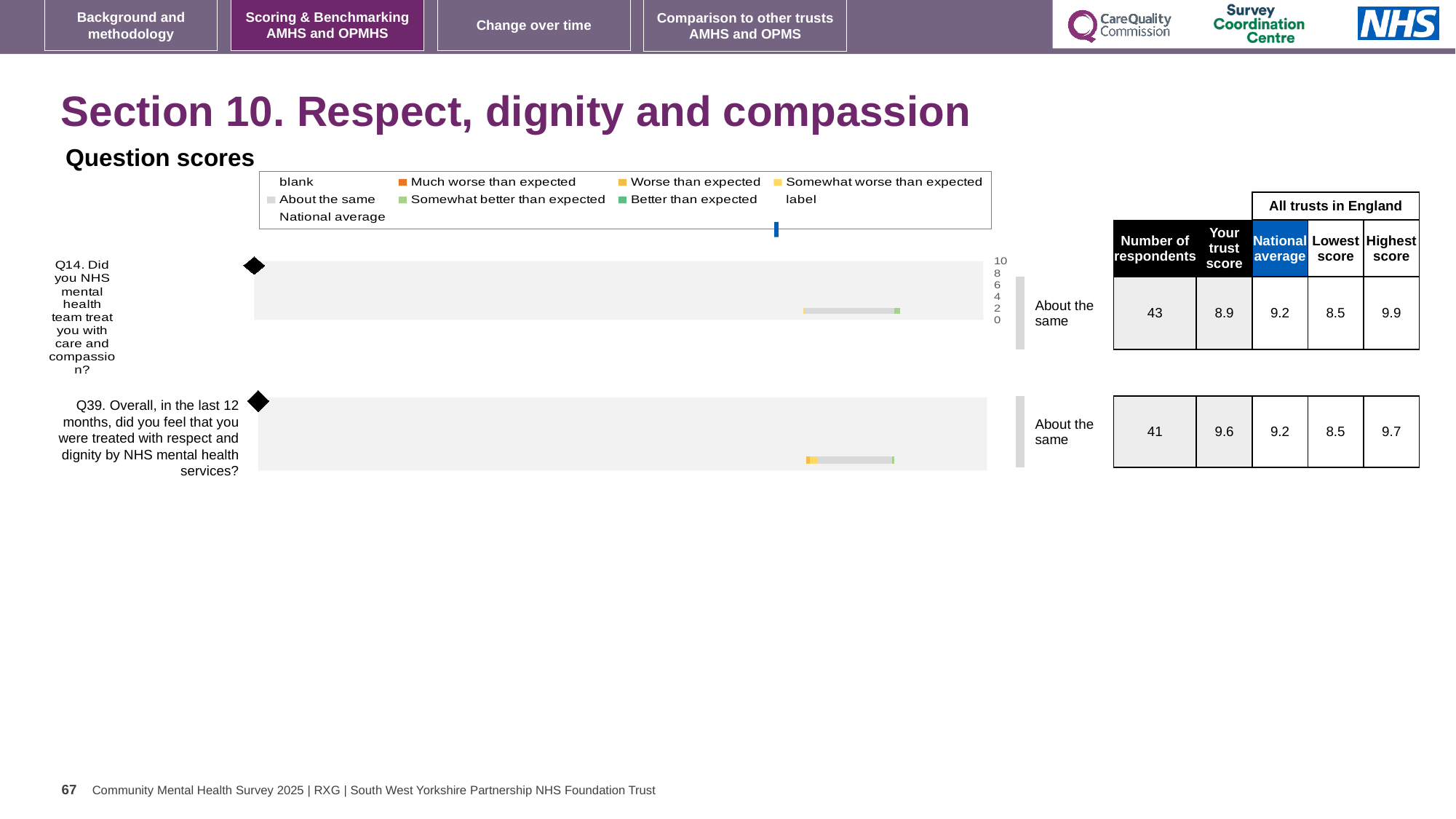
What is the difference between the national average and the trust score for Q14? 0.3 How many questions are plotted in the Question scores chart? 2 What benchmark category is shown for Q39? About the same What is the trust score for Q14 (care and compassion)? 8.9 What is the highest score among all trusts in England for Q39? 9.7 What is the difference between the highest and lowest scores for Q39? 1.2 What is the national average score for Q14? 9.2 Which question has the higher trust score, Q14 or Q39? Q39 How many respondents answered Q14? 43 What is the trust score for Q39 (respect and dignity)? 9.6 What is the lowest score among all trusts in England for Q14? 8.5 How many respondents answered Q39? 41